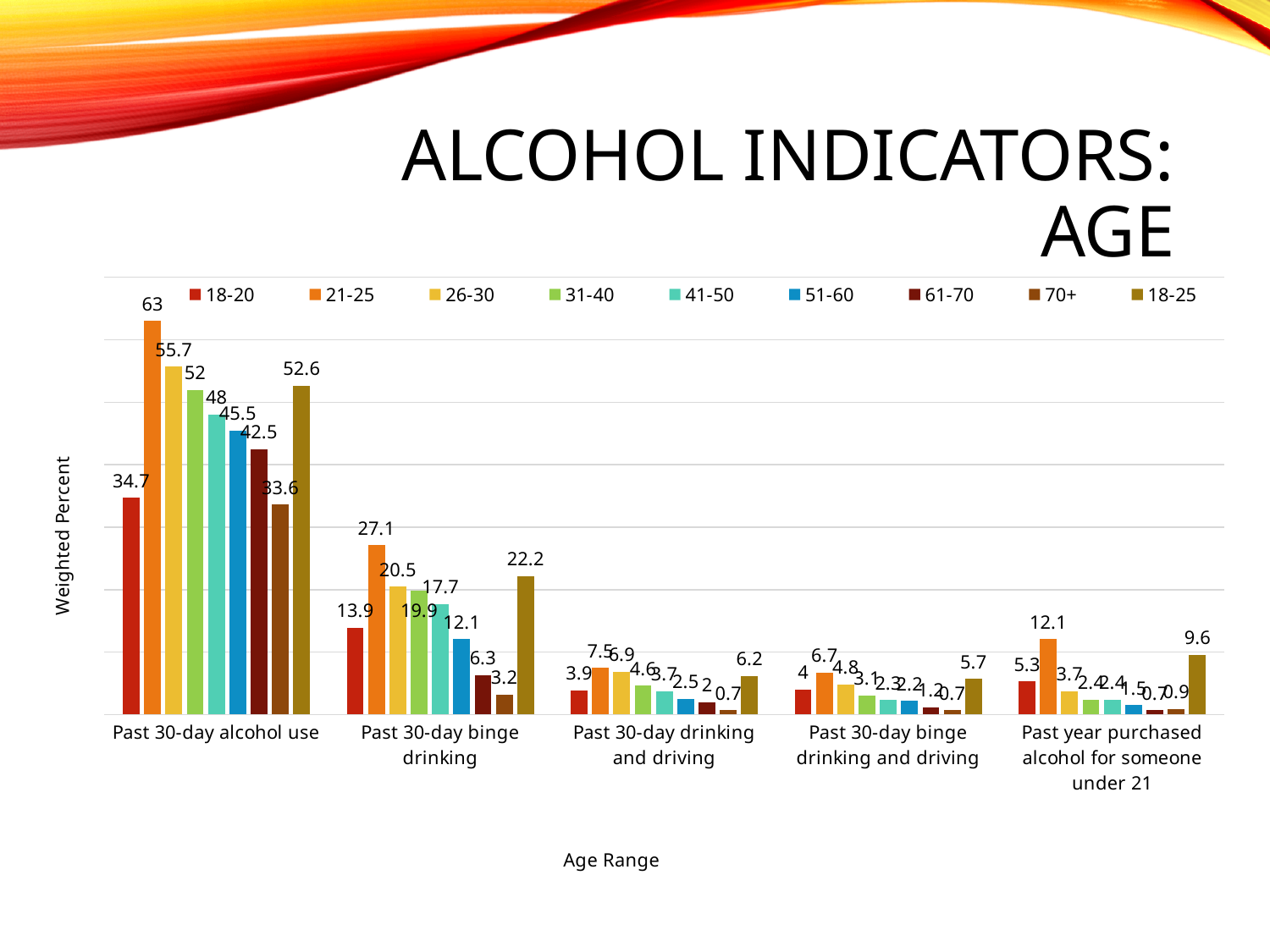
What is the value for the 21-25 age group for Past 30-day alcohol use? 63 Which age group has the lowest value for Past 30-day binge drinking? 70+ What is the value for the 18-25 age group for Past 30-day binge drinking? 22.2 What is the difference between the 21-25 and 18-20 values for Past 30-day alcohol use? 28.3 What is the difference between the 21-25 and 18-25 values for Past 30-day binge drinking? 4.9 How many age groups does the legend list? 9 For Past 30-day alcohol use, which is larger: the value for 26-30 or the value for 18-25? 26-30 What type of chart is shown on the slide? Bar chart What is the label of the y axis? Weighted Percent What is the value for the 21-25 age group for Past year purchased alcohol for someone under 21? 12.1 Which age group has the highest value for Past 30-day alcohol use? 21-25 How many indicator categories are shown on the x axis? 5